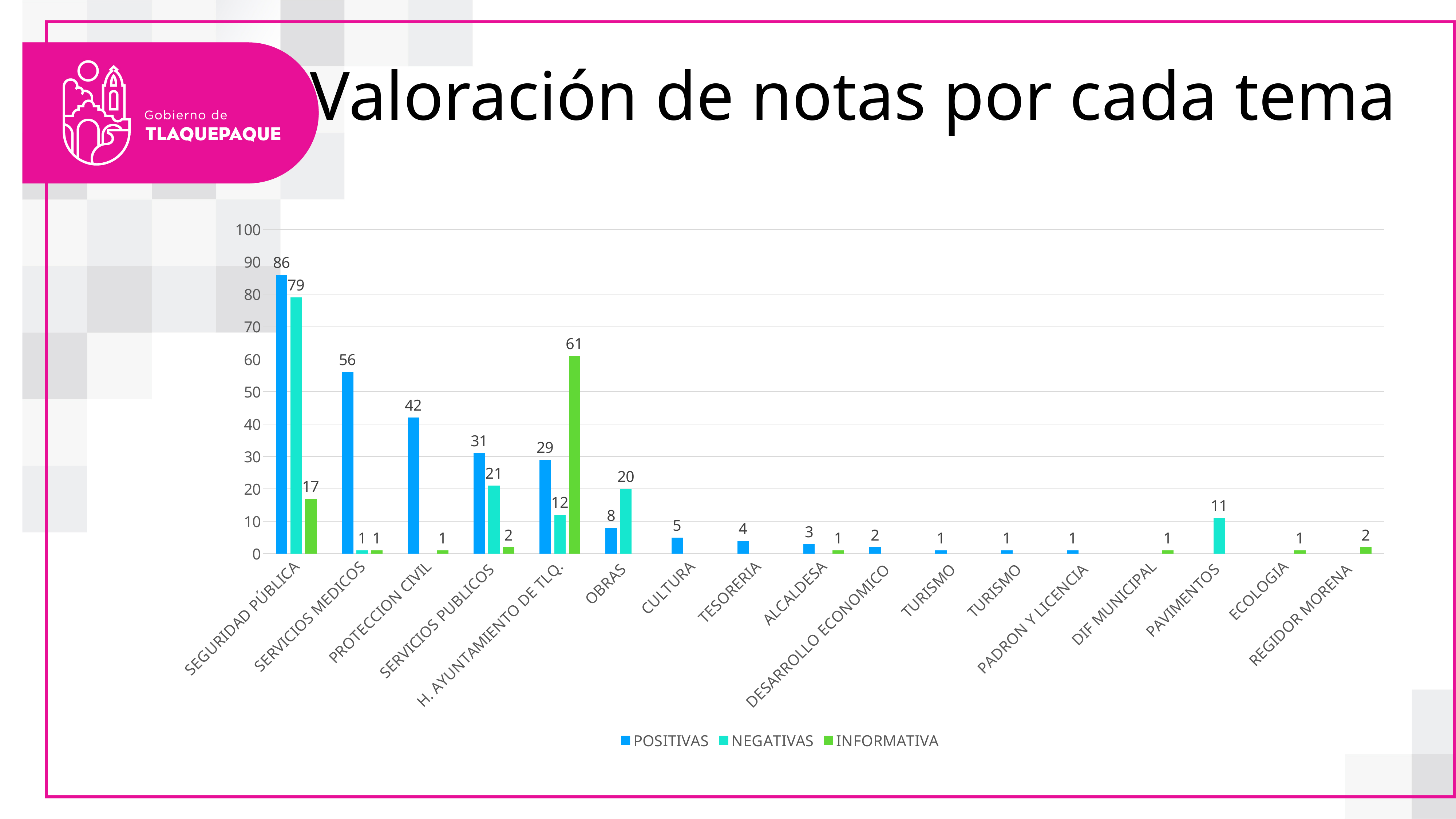
For OBRAS, which is larger: POSITIVAS or NEGATIVAS? NEGATIVAS What is the NEGATIVAS value for PAVIMENTOS? 11 What is the INFORMATIVA value for H. AYUNTAMIENTO DE TLQ.? 61 What is the NEGATIVAS value for OBRAS? 20 What is the difference between the POSITIVAS and NEGATIVAS values for SERVICIOS PUBLICOS? 10 What kind of chart is shown on the slide? Bar chart How many series does the legend list? 3 What is the difference between the POSITIVAS and NEGATIVAS values for SEGURIDAD PÚBLICA? 7 What is the POSITIVAS value for SEGURIDAD PÚBLICA? 86 How many categories are shown on the x axis? 17 Which category has the highest INFORMATIVA value? H. AYUNTAMIENTO DE TLQ. Which category has the highest POSITIVAS value? SEGURIDAD PÚBLICA